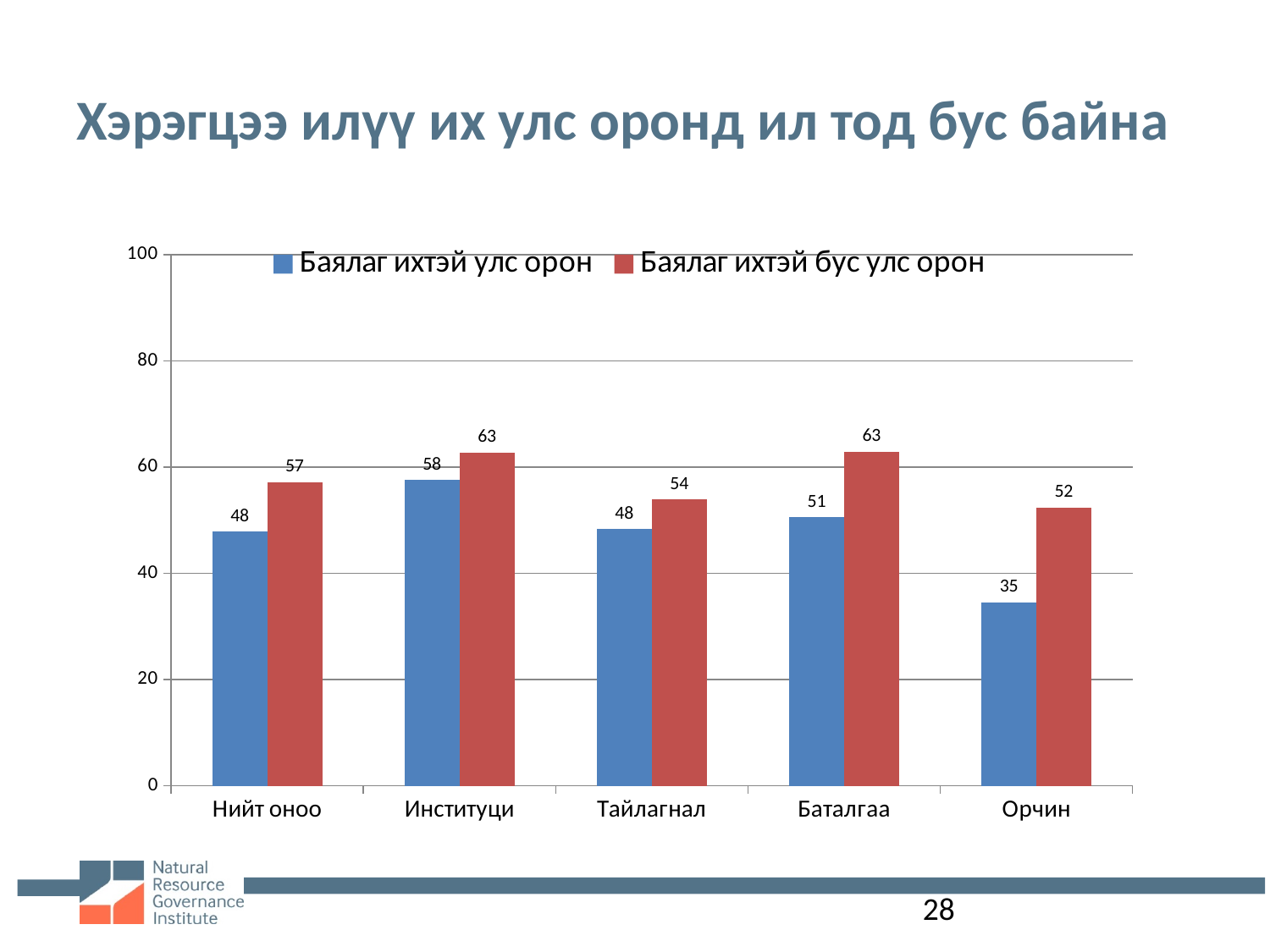
How many categories are shown on the x axis? 5 What is the value for Баялаг ихтэй улс орон in the Нийт оноо category? 48 Which category has the lowest value for Баялаг ихтэй улс орон? Орчин What kind of chart is shown on the slide? Bar chart What is the value for Баялаг ихтэй бус улс орон in the Орчин category? 52 Which category has the highest value for Баялаг ихтэй улс орон? Институци What is the difference between the two series in the Нийт оноо category? 9 What colour are the bars for Баялаг ихтэй бус улс орон? Red What is the value for Баялаг ихтэй улс орон in the Институци category? 58 How many series does the legend list? 2 What is the difference between the two series in the Орчин category? 17 In the Баталгаа category, which series has the larger value? Баялаг ихтэй бус улс орон